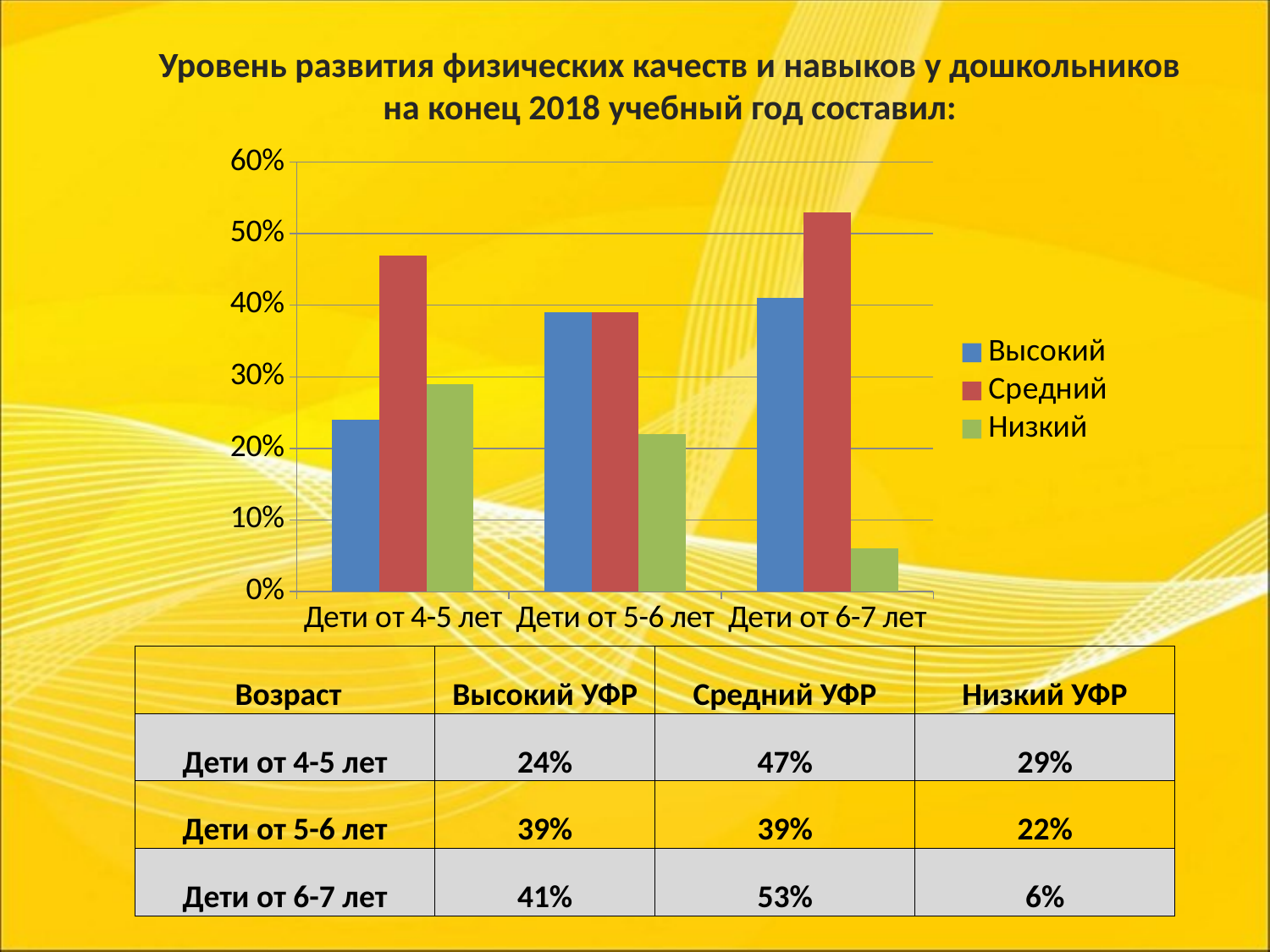
Which age group has the highest value for the Средний series? Дети от 6-7 лет How many age-group categories are shown on the x axis of the chart? 3 How many series does the chart legend list? 3 Which age group has the lowest value for the Низкий series? Дети от 6-7 лет What kind of chart is shown on the slide? bar chart What is the value of the Высокий series for Дети от 5-6 лет? 39% Which is larger for Дети от 6-7 лет: the Высокий value or the Низкий value? Высокий What is the value of the Низкий series for Дети от 4-5 лет? 29% What is the value of the Средний series for Дети от 6-7 лет? 53% Is the Средний value for Дети от 6-7 лет greater or less than 50%? greater Does the Низкий series rise or fall across the age groups from left to right? fall What is the difference between the Средний and Высокий values for Дети от 4-5 лет? 23%